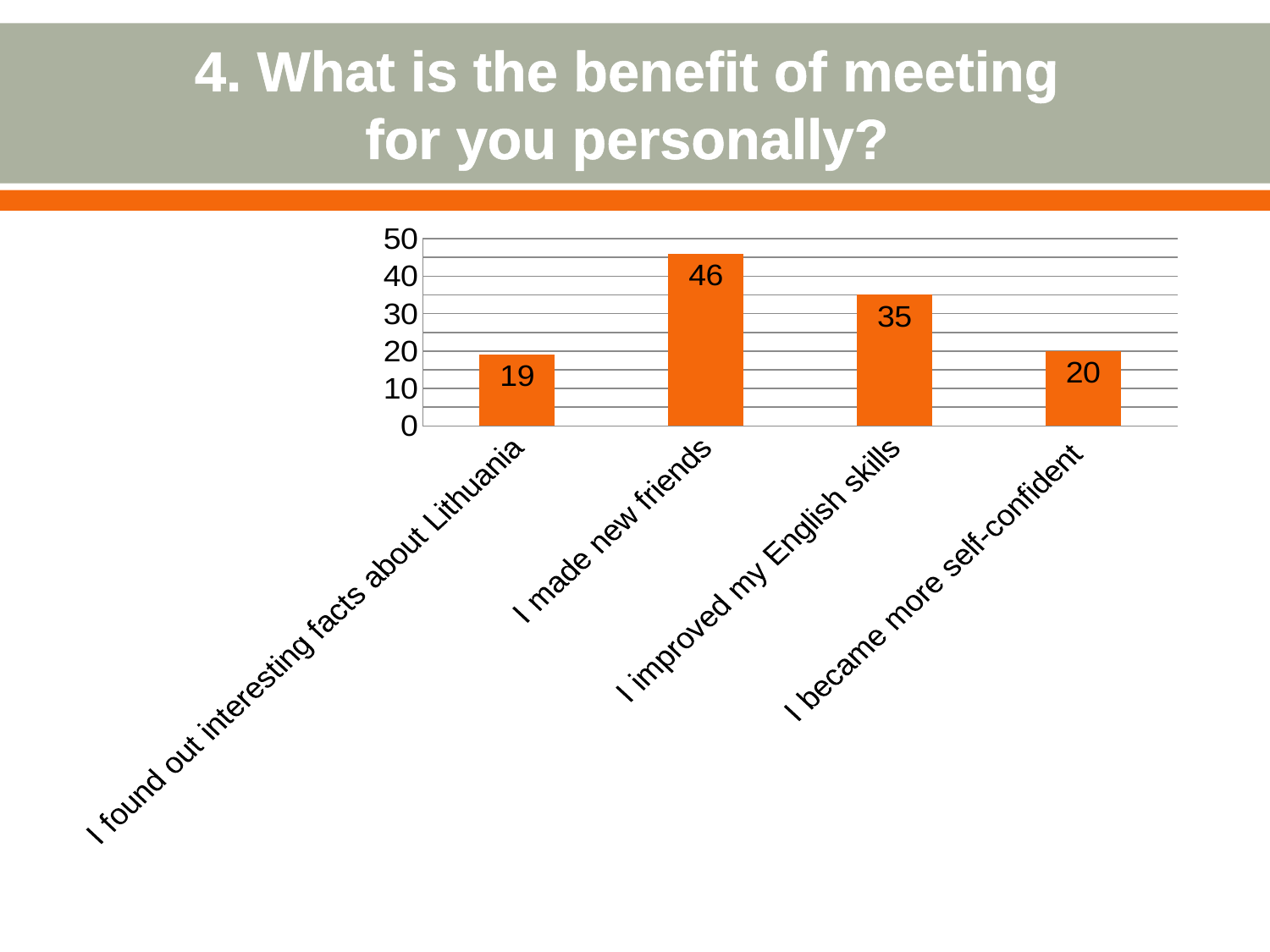
What is the value for "I improved my English skills"? 35 What is the title of the slide? 4. What is the benefit of meeting for you personally? Is the value for "I made new friends" greater or less than 40? greater What is the value for "I became more self-confident"? 20 Which category has the lowest value? I found out interesting facts about Lithuania What is the difference between the values for "I made new friends" and "I improved my English skills"? 11 What is the value for "I made new friends"? 46 What kind of chart is shown on the slide? bar chart Which is larger, the value for "I improved my English skills" or the value for "I became more self-confident"? I improved my English skills How many categories are shown in the chart? 4 Which category has the highest value? I made new friends What is the value for "I found out interesting facts about Lithuania"? 19